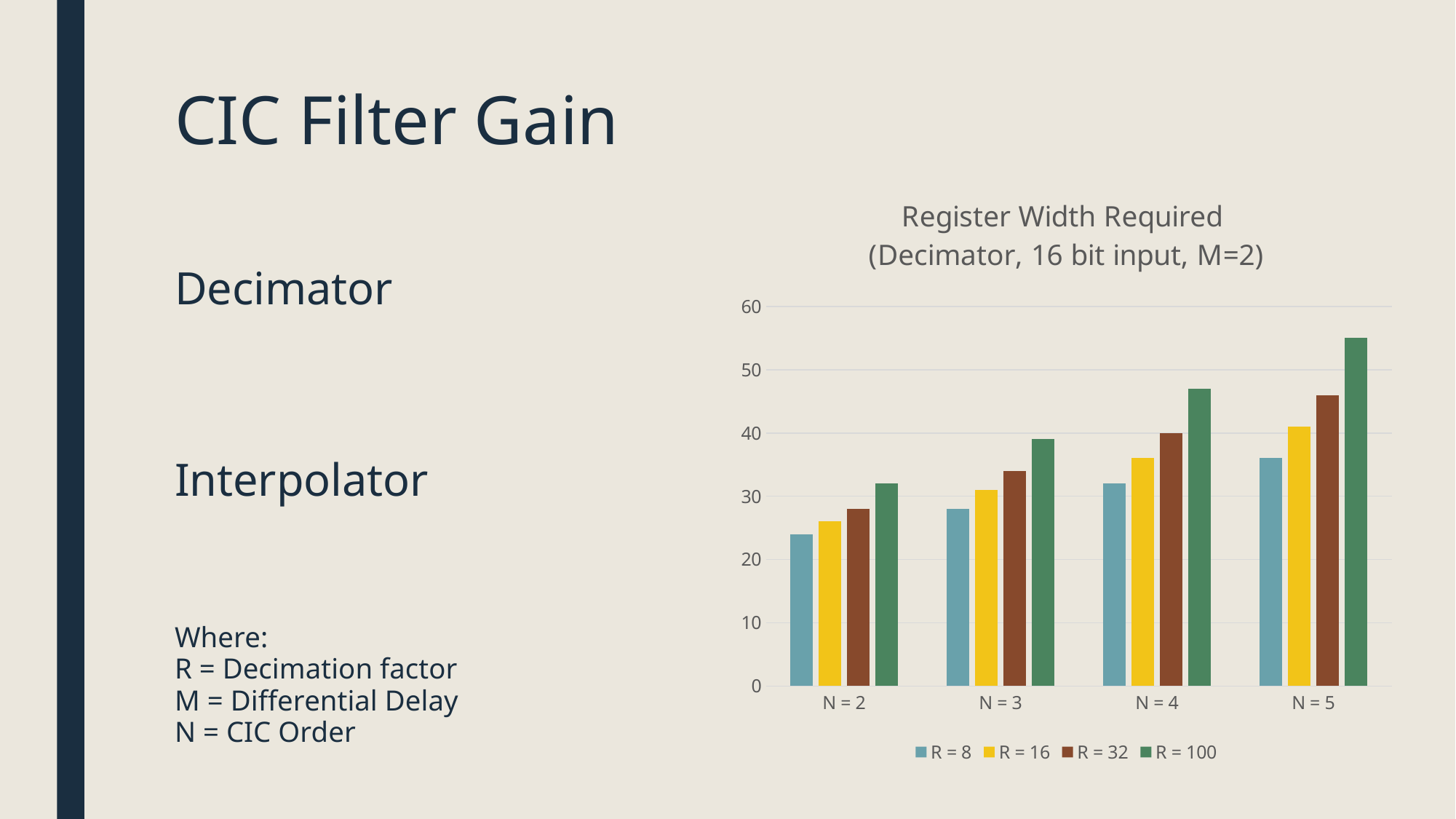
What kind of chart is shown on the slide? bar chart Is the value for R = 8 at N = 2 greater or less than 30? less What is the title of the chart? Register Width Required (Decimator, 16 bit input, M=2) Is the value for R = 100 at N = 4 greater or less than 40? greater How many series does the chart legend list? 4 Which legend entry is shown in green? R = 100 How many categories are shown on the x axis of the chart? 4 Which series has the tallest bar at N = 5? R = 100 Do the values for R = 100 rise or fall as N increases from N = 2 to N = 5? rise Is the value for R = 100 at N = 5 greater or less than 50? greater Which series has the shortest bar at N = 2? R = 8 Which is larger: R = 32 at N = 3 or R = 8 at N = 5? R = 8 at N = 5